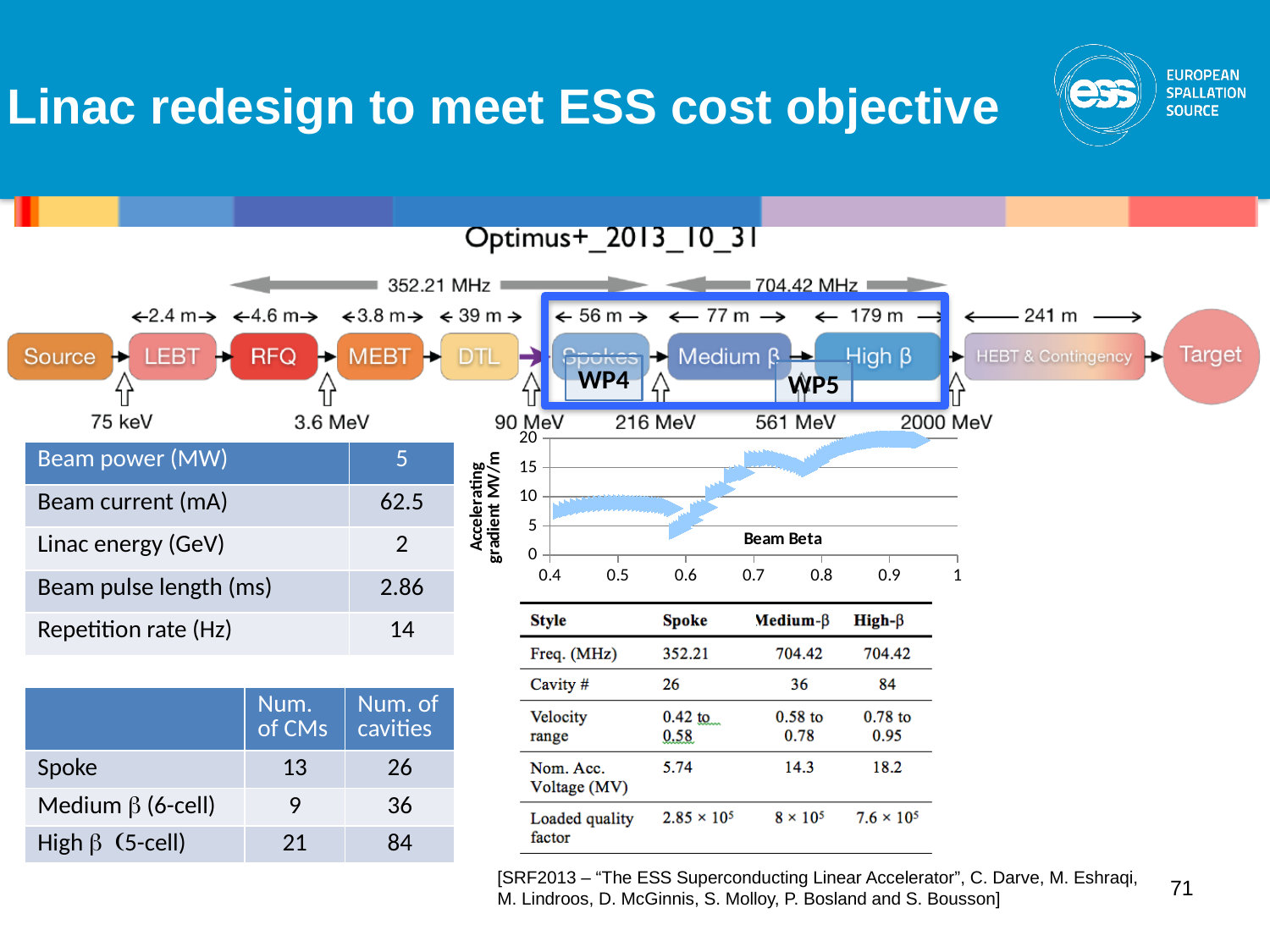
In the accelerating gradient chart, does the accelerating gradient overall rise or fall as beam beta increases from 0.4 to 1? rise In the accelerating gradient chart, is the accelerating gradient at a beam beta of 0.4 greater or less than 10? less In the accelerating gradient chart, is the lowest accelerating gradient plotted greater or less than 5? less In the accelerating gradient chart, is the accelerating gradient at a beam beta of 0.9 higher or lower than at a beam beta of 0.4? higher What is the label of the horizontal axis of the accelerating gradient chart? Beam Beta What kind of chart is the accelerating gradient chart on the slide? scatter chart What is the label of the vertical axis of the accelerating gradient chart? Accelerating gradient MV/m What is the highest tick value shown on the vertical axis of the accelerating gradient chart? 20 In the accelerating gradient chart, is the accelerating gradient at a beam beta of 0.7 greater or less than 10? greater